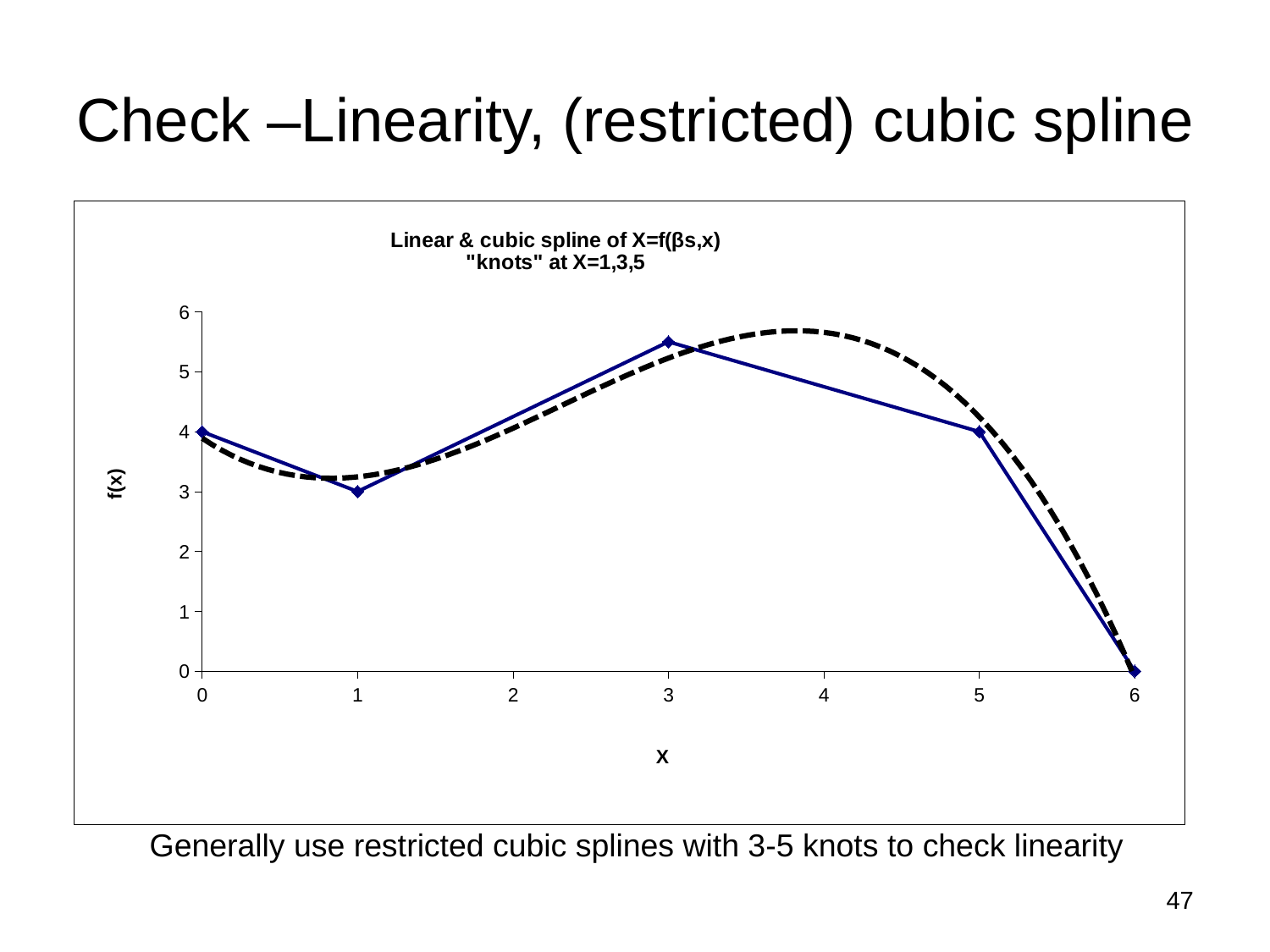
What kind of chart is shown on the slide? line chart What is the value of f(x) at x = 1 on the solid line? 3 How many marked data points are on the solid line? 5 What is the label of the vertical axis? f(x) What is the value of f(x) at x = 6 on the solid line? 0 Is the value of f(x) at x = 3 on the solid line greater or less than 5? greater What is the title of the chart? Linear & cubic spline of X=f(βs,x) "knots" at X=1,3,5 At which x value does the solid line reach its highest f(x)? 3 What is the value of f(x) at x = 0 on the solid line? 4 Does the solid line rise or fall between x = 5 and x = 6? fall At which x value does the solid line reach its lowest f(x)? 6 What is the value of f(x) at x = 5 on the solid line? 4